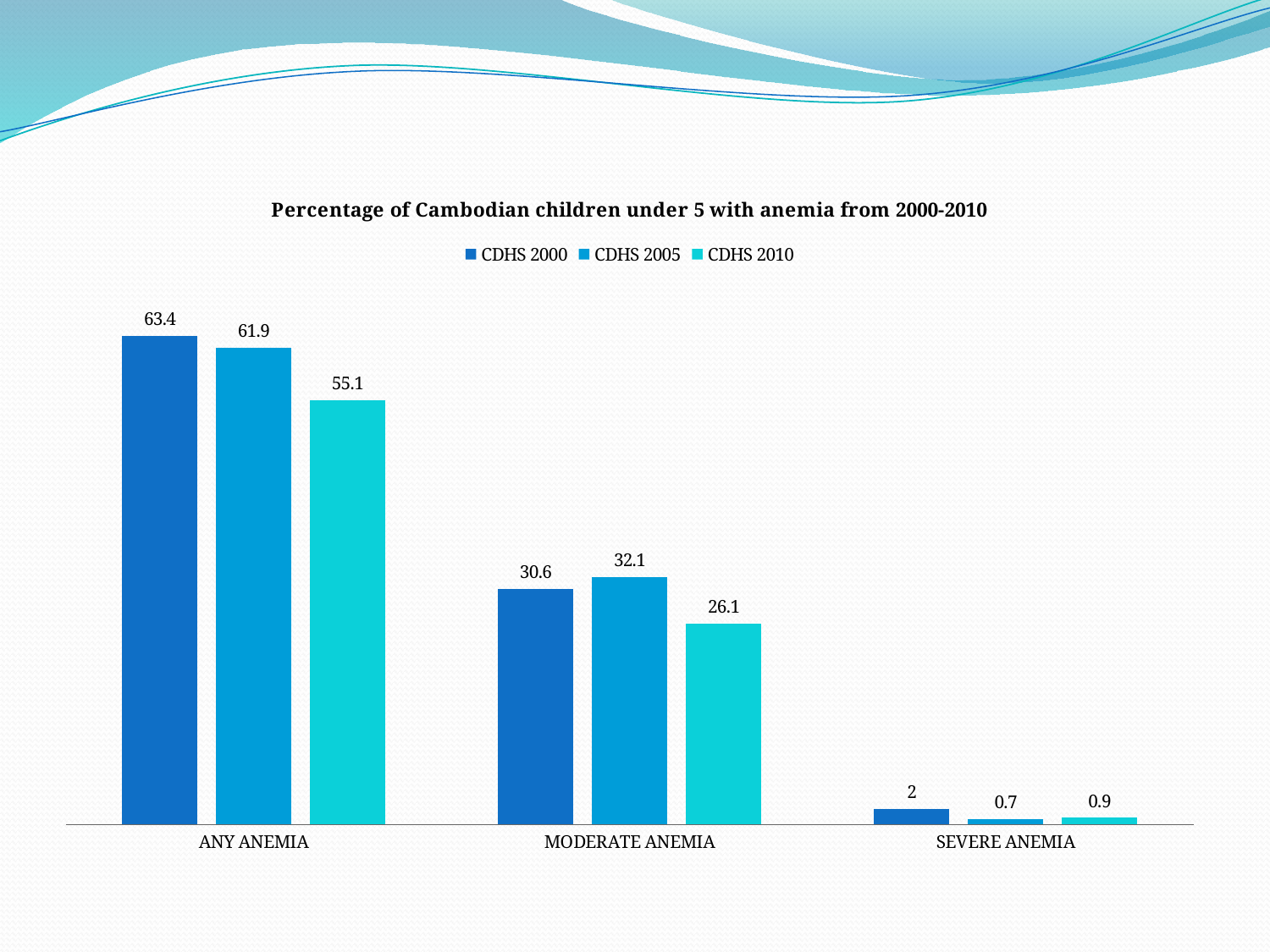
How many categories are shown on the x axis? 3 Which is larger in the MODERATE ANEMIA category, CDHS 2000 or CDHS 2005? CDHS 2005 Which survey has the lowest value in the SEVERE ANEMIA category? CDHS 2005 What is the value for CDHS 2010 in the MODERATE ANEMIA category? 26.1 How many series does the legend list? 3 What is the title of the chart? Percentage of Cambodian children under 5 with anemia from 2000-2010 What kind of chart is shown on the slide? Bar chart What is the difference between the CDHS 2005 and CDHS 2010 values for MODERATE ANEMIA? 6 What is the value for CDHS 2000 in the ANY ANEMIA category? 63.4 Which category has the highest value for CDHS 2005? ANY ANEMIA What is the difference between the CDHS 2000 and CDHS 2010 values for ANY ANEMIA? 8.3 What is the value for CDHS 2005 in the SEVERE ANEMIA category? 0.7